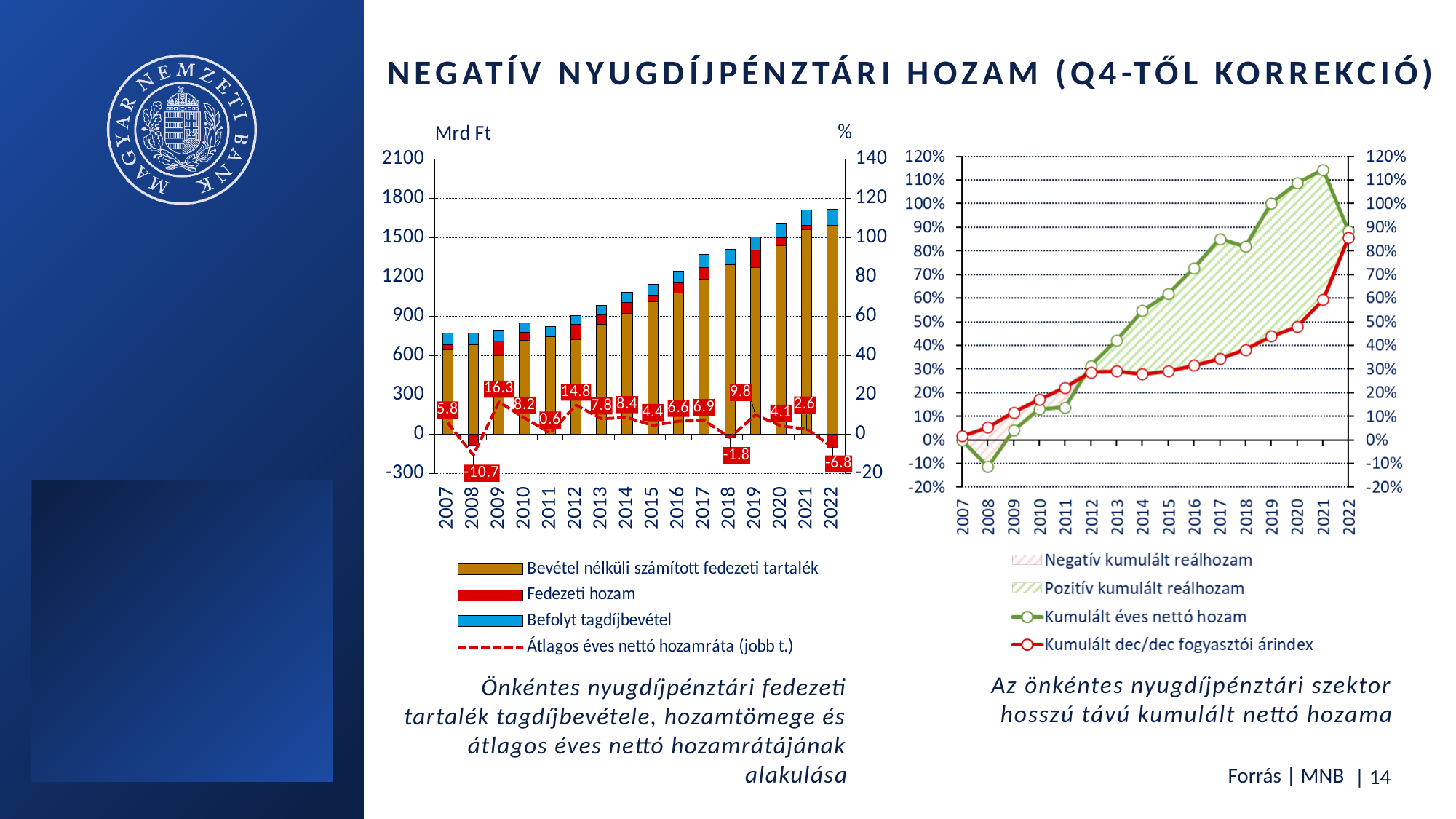
On the left chart, is the total height of the stacked bar for 2022 greater or less than 1500 Mrd Ft? greater On the right chart, is the Kumulált éves nettó hozam value for 2021 greater or less than 100%? greater On the left chart, how many series does the legend list? 4 On the right chart, does the Kumulált éves nettó hozam line generally rise or fall between 2008 and 2021? rise On the left chart, what is the Átlagos éves nettó hozamráta value for 2009? 16.3 On the left chart, what is the Átlagos éves nettó hozamráta value for 2022? -6.8 On the left chart, in which year is the Átlagos éves nettó hozamráta highest? 2009 On the left chart, which year has the higher Átlagos éves nettó hozamráta, 2019 or 2020? 2019 On the left chart, in which year is the Átlagos éves nettó hozamráta lowest? 2008 On the left chart, what is the difference between the Átlagos éves nettó hozamráta values for 2009 and 2012? 1.5 On the left chart, how many years are shown on the x axis? 16 On the right chart, how many entries does the legend list? 4